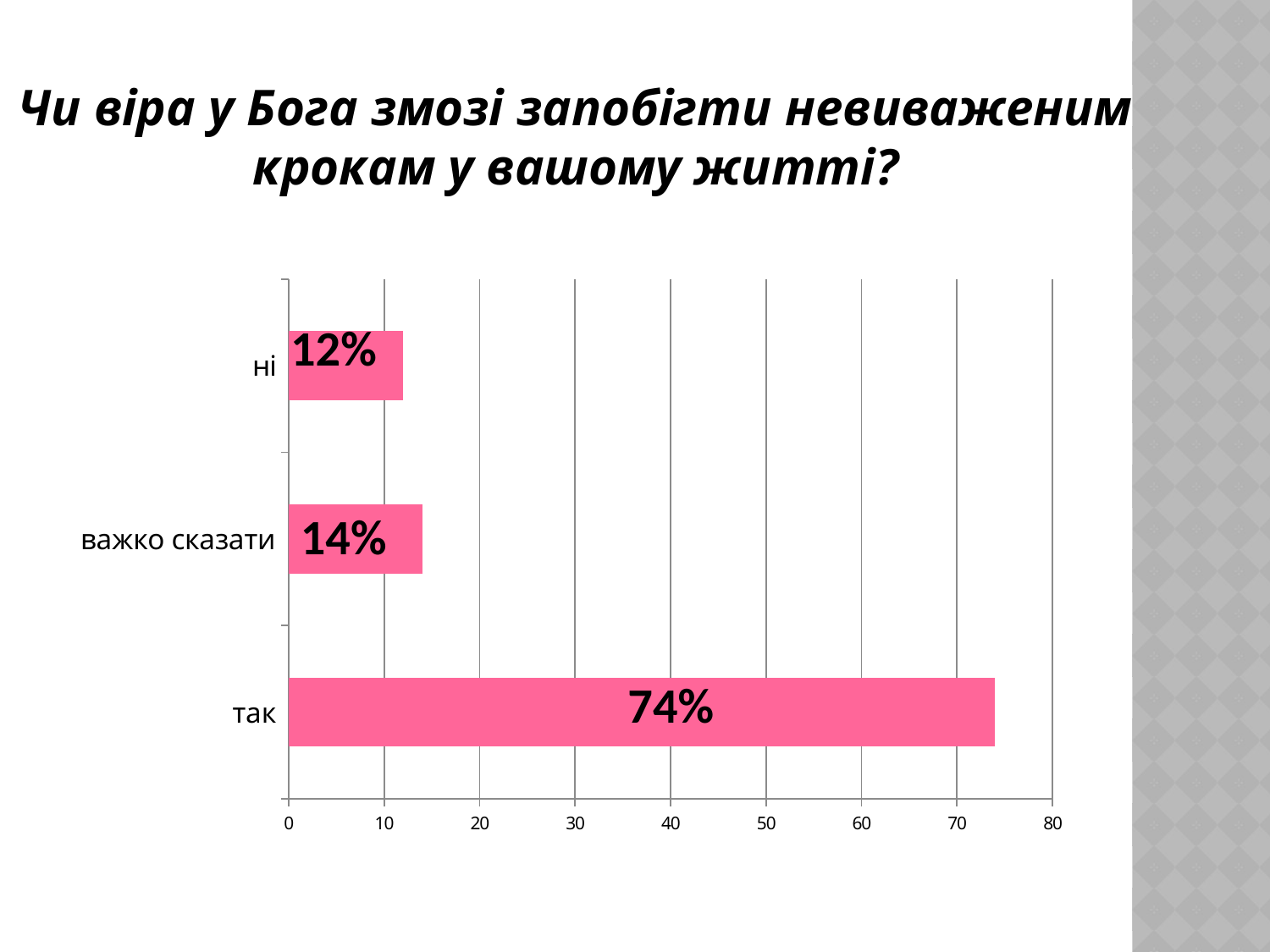
Which category has the lowest value? ні Which is larger, the value for "важко сказати" or the value for "ні"? важко сказати What is the difference between the values for "важко сказати" and "ні"? 2% What is the difference between the values for "так" and "важко сказати"? 60% What is the value for "так"? 74% What kind of chart is shown on the slide? bar chart What is the value for "ні"? 12% Is the value for "так" greater or less than 70? greater What is the highest value shown on the horizontal axis? 80 How many categories are shown in the chart? 3 Which category has the highest value? так What is the value for "важко сказати"? 14%